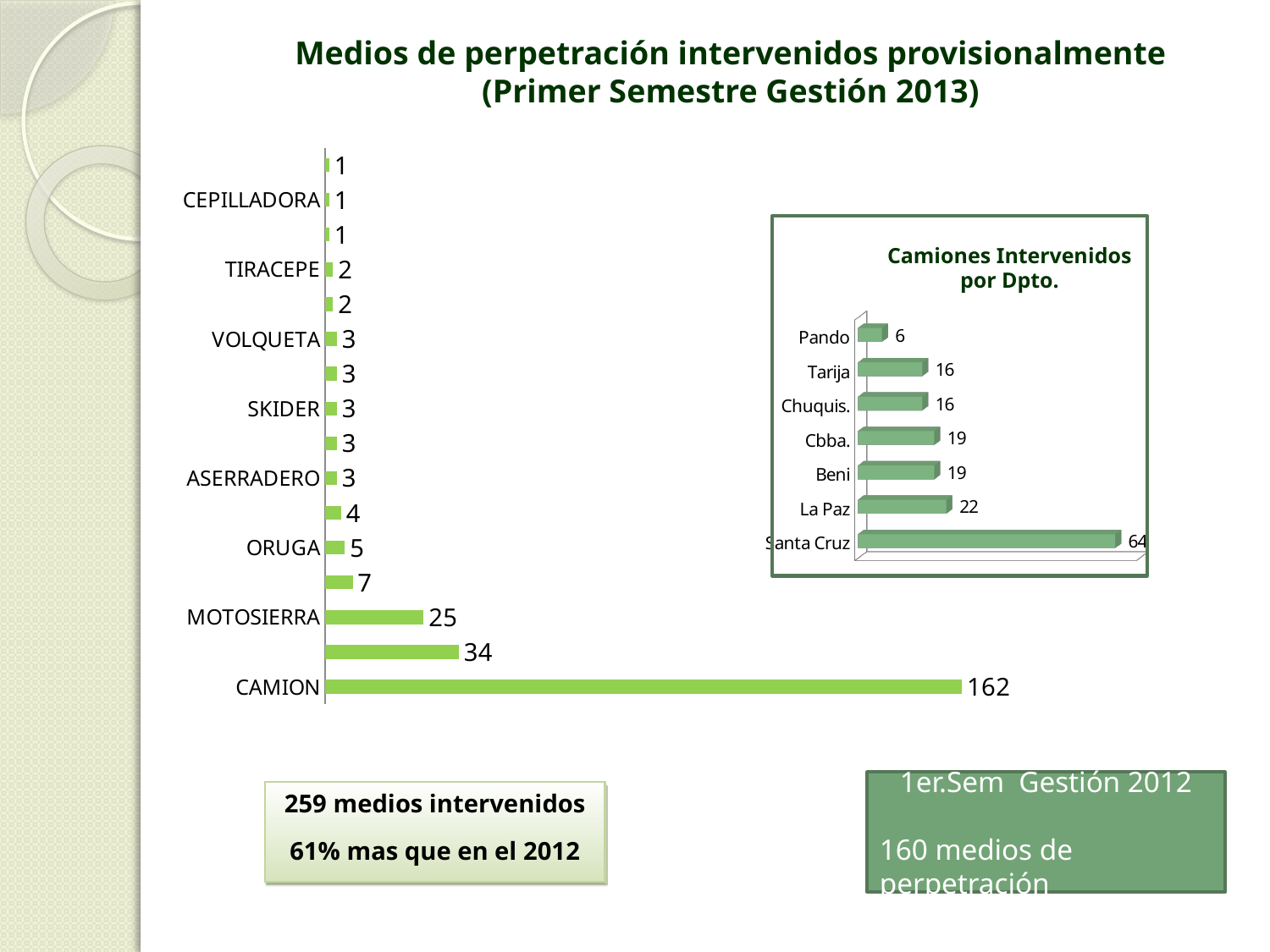
In the large chart on the left of the slide, what is the value for MOTOSIERRA? 25 In the chart titled 'Camiones Intervenidos por Dpto.', what is the difference between the values for Santa Cruz and La Paz? 42 In the chart titled 'Camiones Intervenidos por Dpto.', what is the value for Santa Cruz? 64 What kind of chart is the large chart on the left of the slide? Bar chart In the chart titled 'Camiones Intervenidos por Dpto.', which department has the lowest value? Pando In the chart titled 'Camiones Intervenidos por Dpto.', how many departments are shown? 7 In the large chart on the left of the slide, which category has the highest value? CAMION In the chart titled 'Camiones Intervenidos por Dpto.', which department has the highest value? Santa Cruz In the large chart on the left of the slide, what is the difference between the values for CAMION and MOTOSIERRA? 137 In the chart titled 'Camiones Intervenidos por Dpto.', what is the value for La Paz? 22 In the large chart on the left of the slide, what is the value for CAMION? 162 In the large chart on the left of the slide, which is larger, the value for ORUGA or the value for TIRACEPE? ORUGA